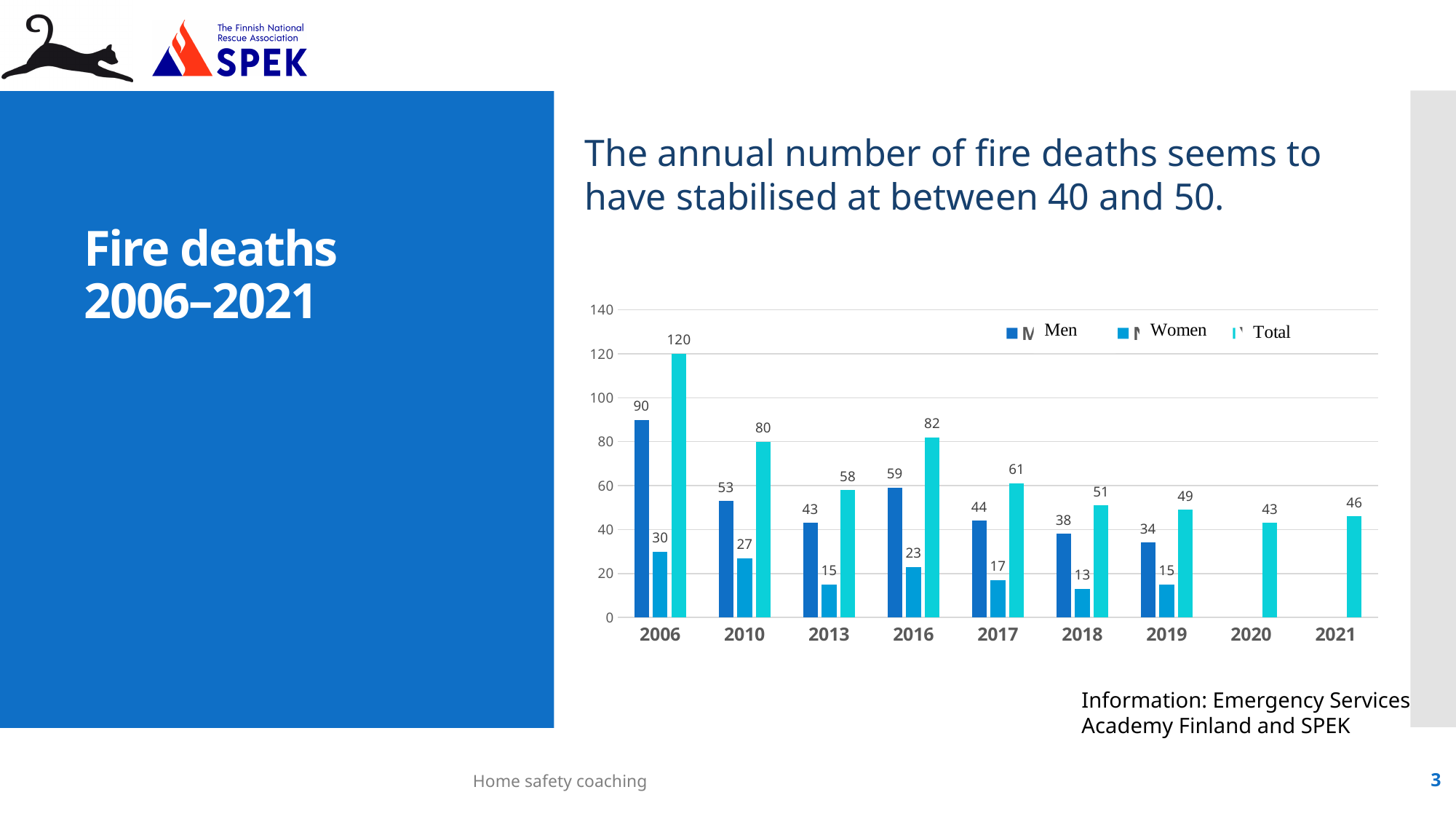
What is the Total value for 2006? 120 What kind of chart is shown on the slide? bar chart What is the Total value for 2021? 46 What is the Women value for 2018? 13 What is the Men value for 2016? 59 Which year has the lowest Women value? 2018 How many years are shown on the x axis? 9 How many series does the legend list? 3 Which year has the highest Total value? 2006 Which is larger, the Men value for 2017 or the Men value for 2018? 2017 What is the difference between the Total values for 2006 and 2010? 40 Does the Total value rise or fall from 2006 to 2013? fall